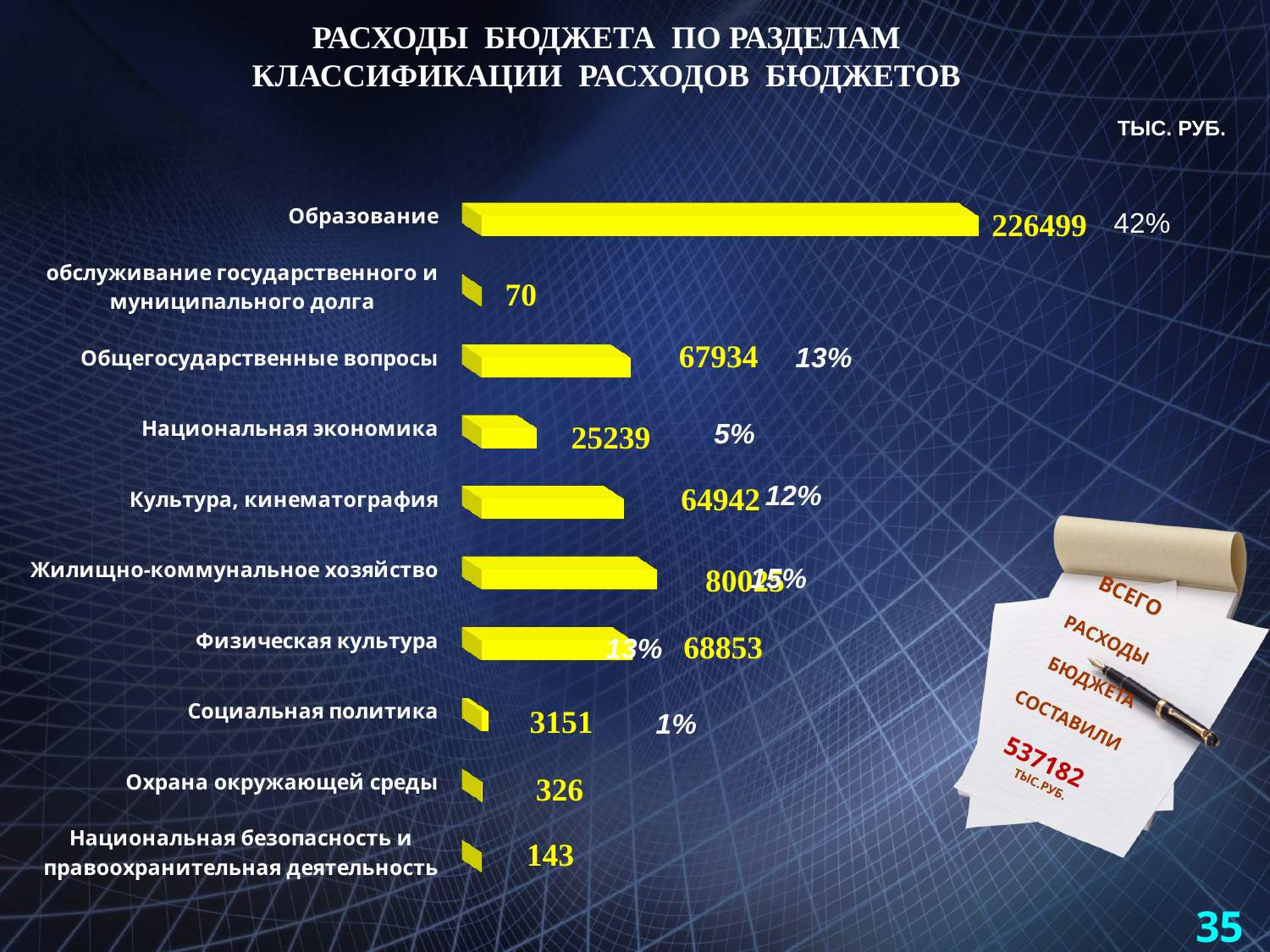
What is the difference between the values for Социальная политика and Охрана окружающей среды? 2825 Which is larger, the value for Физическая культура or the value for Общегосударственные вопросы? Физическая культура What share of the total does Образование account for, as printed on the chart? 42% What is the difference between the values for Общегосударственные вопросы and Культура, кинематография? 2992 What is the value for Общегосударственные вопросы? 67934 Which category has the lowest value? обслуживание государственного и муниципального долга What kind of chart is shown on the slide? bar chart How many categories are shown in the chart? 10 What is the value for Социальная политика? 3151 What is the value for Национальная экономика? 25239 What is the value for Образование? 226499 Which category has the highest value? Образование